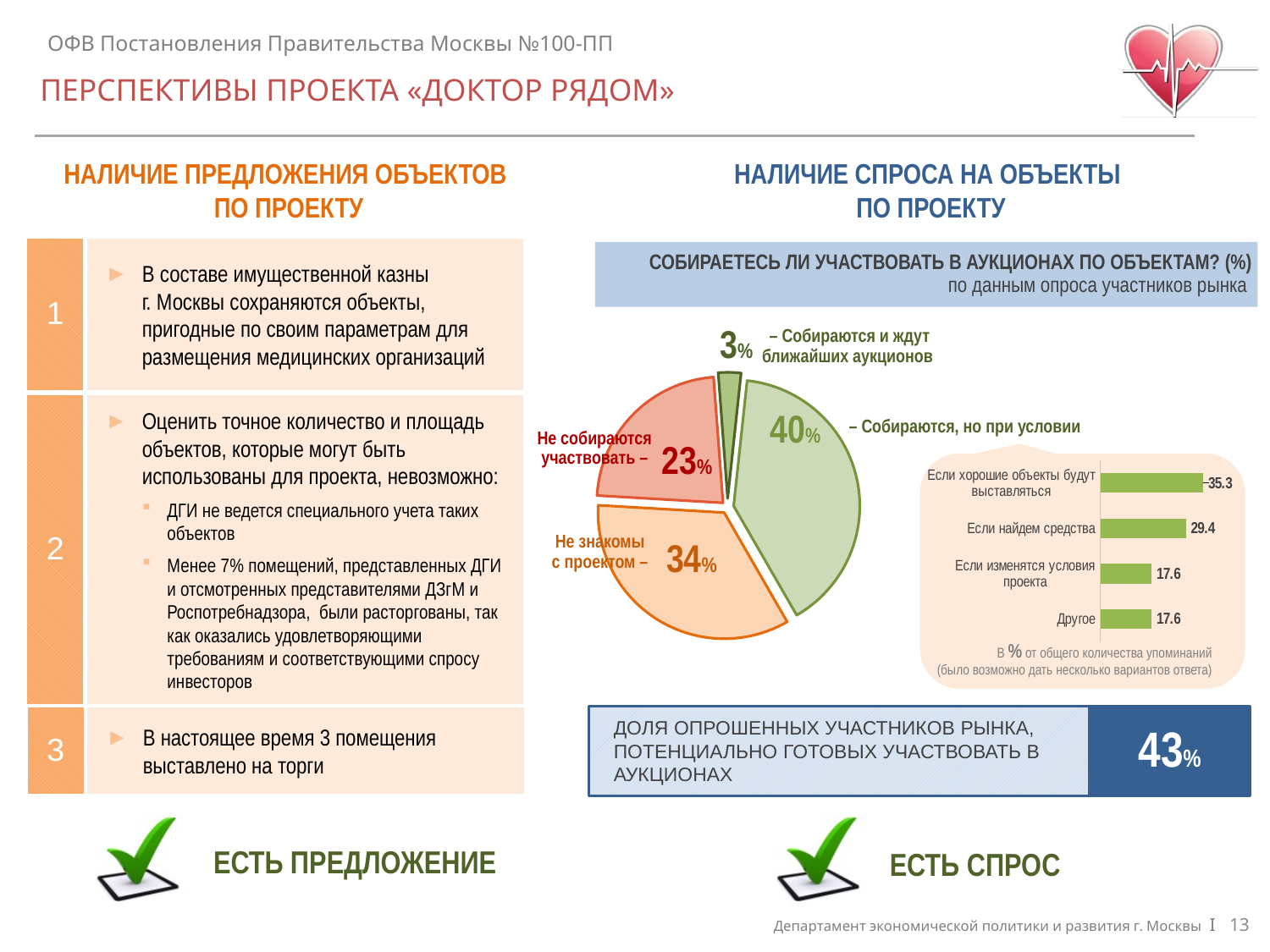
In the pie chart, which category has the largest slice? Собираются, но при условии In the pie chart, what is the difference in percentage points between 'Не знакомы с проектом' and 'Не собираются участвовать'? 11 In the small bar chart on the right, which category has the highest value? Если хорошие объекты будут выставляться In the pie chart, what share is labelled 'Не знакомы с проектом'? 34% In the pie chart 'Собираетесь ли участвовать в аукционах по объектам? (%)', what share is labelled 'Собираются, но при условии'? 40% In the small bar chart on the right, what is the value for 'Если найдем средства'? 29.4 In the small bar chart on the right, what is the value for 'Если хорошие объекты будут выставляться'? 35.3 How many slices does the pie chart have? 4 In the pie chart, what share is labelled 'Собираются и ждут ближайших аукционов'? 3% In the pie chart, what share is labelled 'Не собираются участвовать'? 23% In the pie chart, which category has the smallest slice? Собираются и ждут ближайших аукционов What type of chart is the small chart on the right showing 'Если изменятся условия проекта' and 'Другое'? bar chart